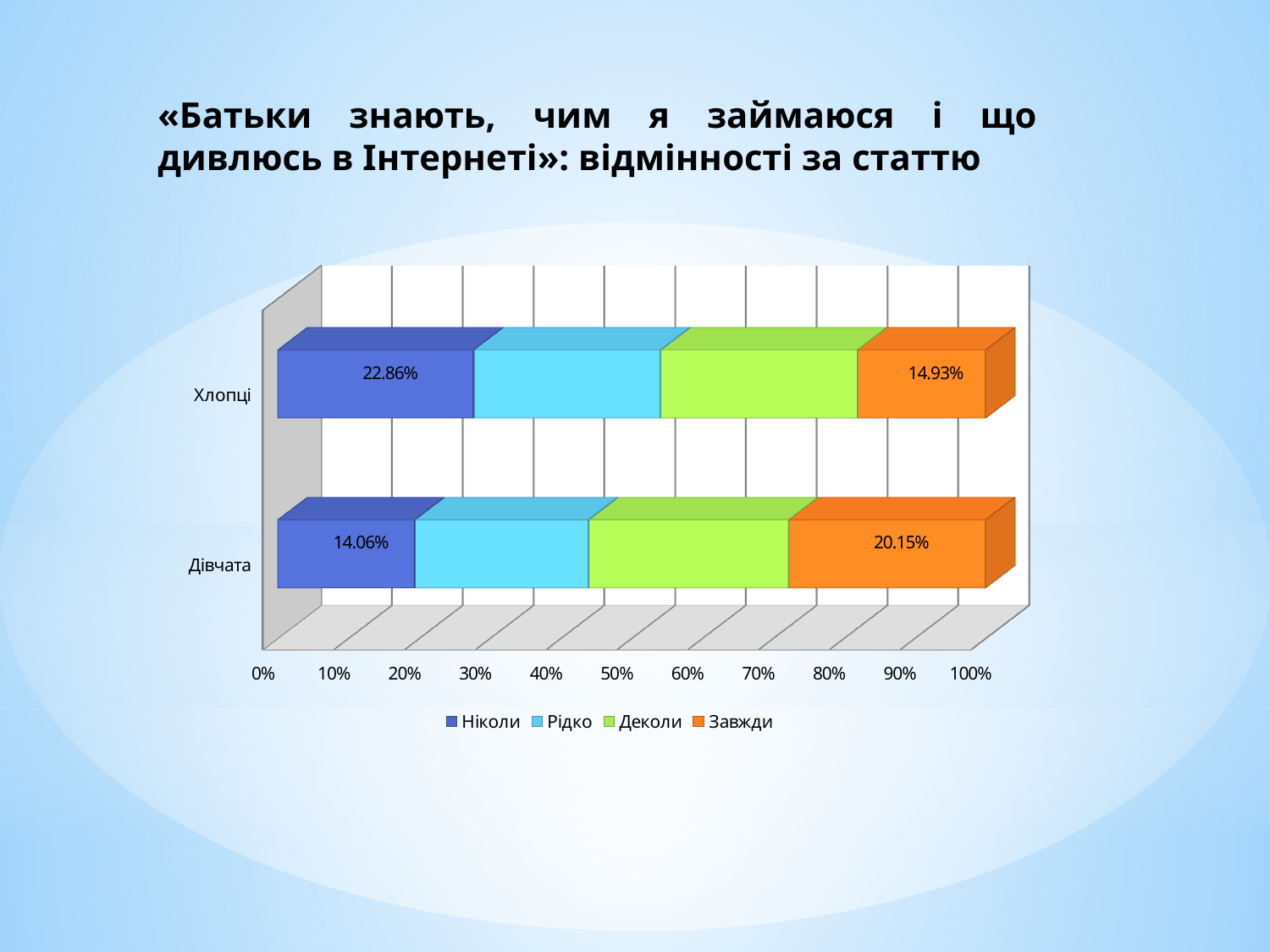
What is the value of Ніколи for Дівчата? 14.06% What is the value of Завжди for Хлопці? 14.93% What kind of chart is shown on the slide? Stacked bar chart Which category has the larger Ніколи value, Хлопці or Дівчата? Хлопці How many series does the legend list? 4 What is the difference between the Завжди values for Дівчата and Хлопці? 5.22% Which category has the larger Завжди value, Хлопці or Дівчата? Дівчата What is the value of Завжди for Дівчата? 20.15% Which series is shown in orange in the legend? Завжди How many categories are shown on the chart? 2 What is the difference between the Ніколи values for Хлопці and Дівчата? 8.80% What is the value of Ніколи for Хлопці? 22.86%